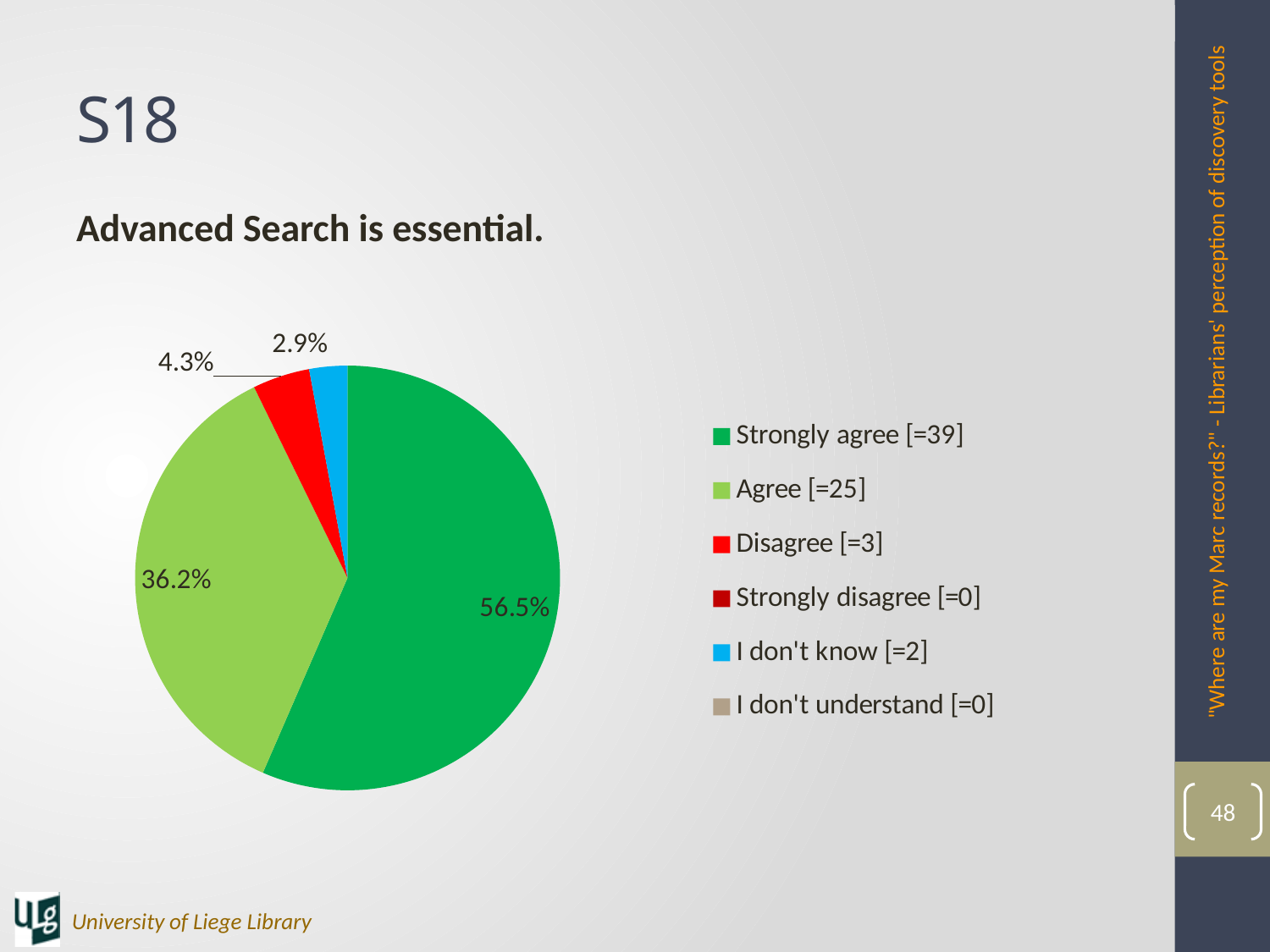
What statement is the chart about, as shown above the pie? Advanced Search is essential. How many respondents does the legend give for Strongly disagree? 0 What kind of chart is shown on the slide? pie chart Which category has the largest slice of the pie? Strongly agree What is the difference in percentage points between the Strongly agree slice and the Agree slice? 20.3 How many entries does the legend list? 6 What percentage of the pie is labelled for Disagree? 4.3% What percentage of the pie is labelled for Strongly agree? 56.5% What percentage of the pie is labelled for I don't know? 2.9% Which of the two is larger: the Agree slice or the Disagree slice? Agree What percentage of the pie is labelled for Agree? 36.2% How many respondents does the legend give for Strongly agree? 39